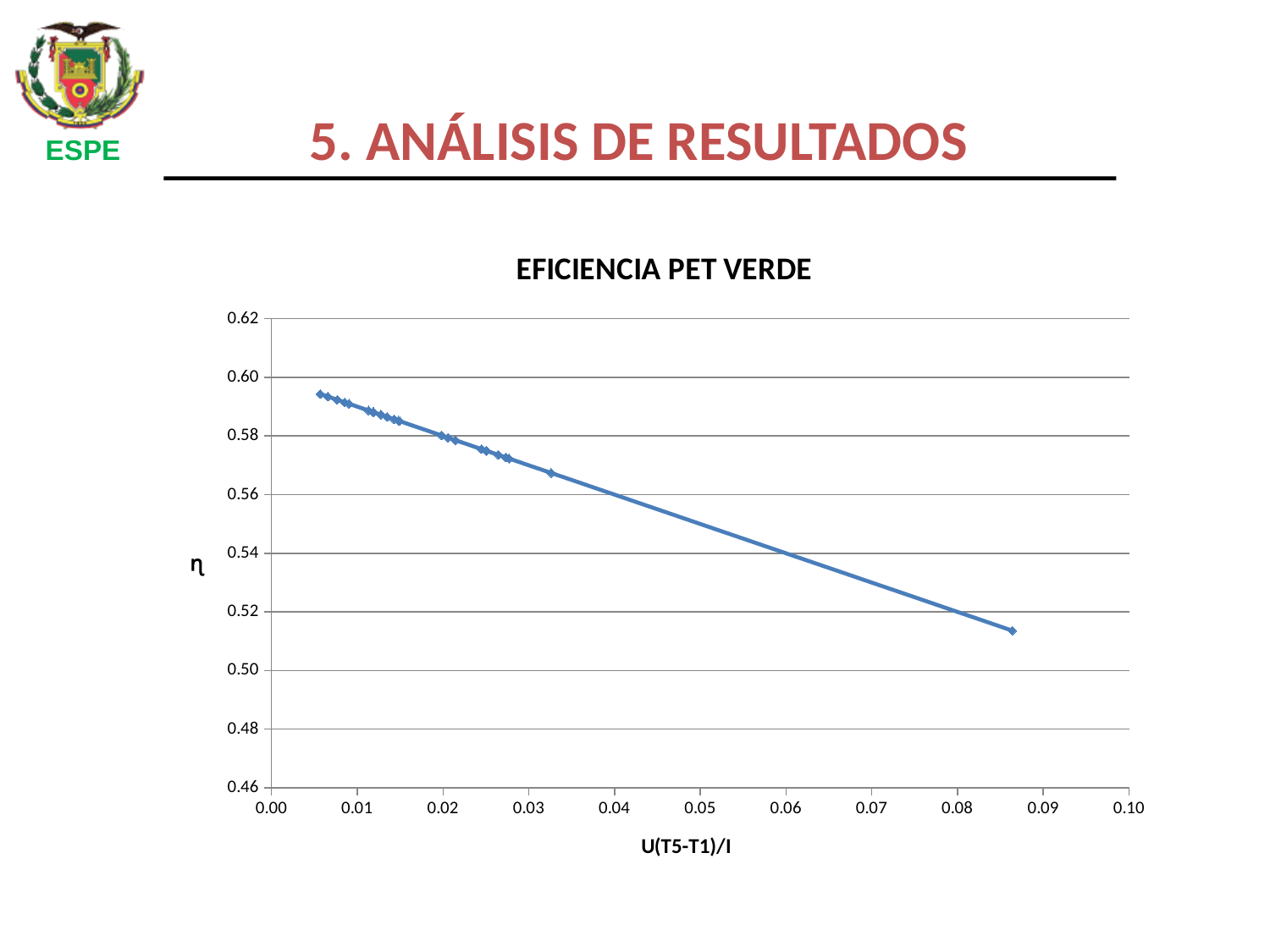
What kind of chart is shown on the slide? line chart Is the η value of the rightmost point (near 0.09 on the x axis) greater or less than 0.50? greater What is the label of the x axis of the chart? U(T5-T1)/I Is the η value of the leftmost point (near 0.01 on the x axis) greater or less than 0.60? less What is the highest value shown on the y axis of the chart? 0.62 Which has the higher η value: the point near 0.01 on the x axis or the point near 0.09 on the x axis? the point near 0.01 Is the η value of the rightmost point (near 0.09 on the x axis) greater or less than 0.52? less Where on the x axis is the point with the lowest η value located: at the left end or the right end of the series? right end Do the values of η rise or fall as U(T5-T1)/I increases along the x axis? fall What is the title of the chart? EFICIENCIA PET VERDE